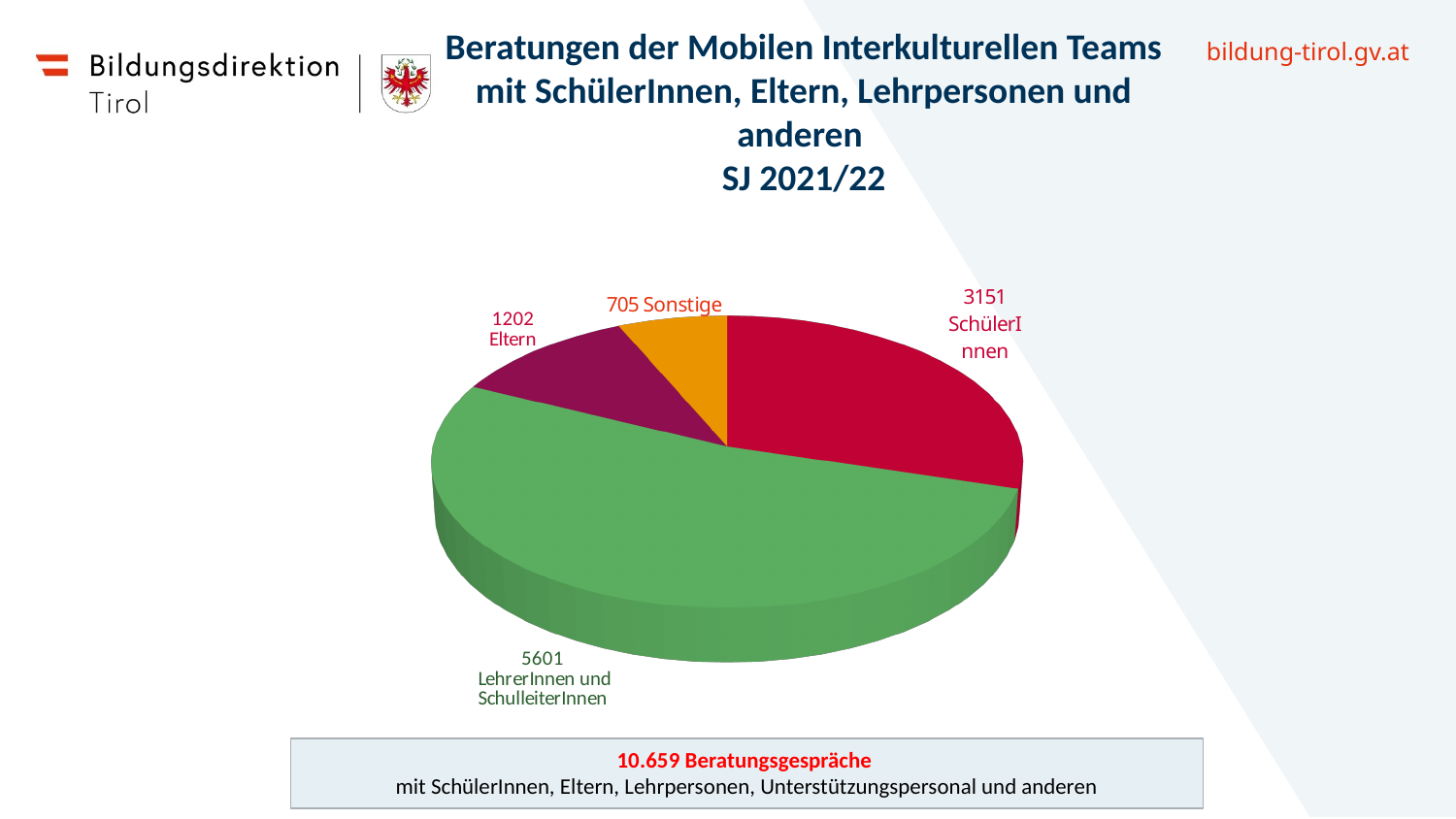
What is the difference between the values for LehrerInnen und SchulleiterInnen and SchülerInnen? 2450 What kind of chart is shown on the slide? pie chart What is the total number of Beratungsgespräche stated on the slide? 10.659 What is the value for SchülerInnen? 3151 What is the value for Eltern? 1202 What is the value for Sonstige? 705 Which is larger, the value for SchülerInnen or the value for Eltern? SchülerInnen What is the difference between the values for Eltern and Sonstige? 497 Which category has the smallest slice of the pie? Sonstige Which category has the largest slice of the pie? LehrerInnen und SchulleiterInnen What is the value for LehrerInnen und SchulleiterInnen? 5601 How many slices does the pie chart have? 4